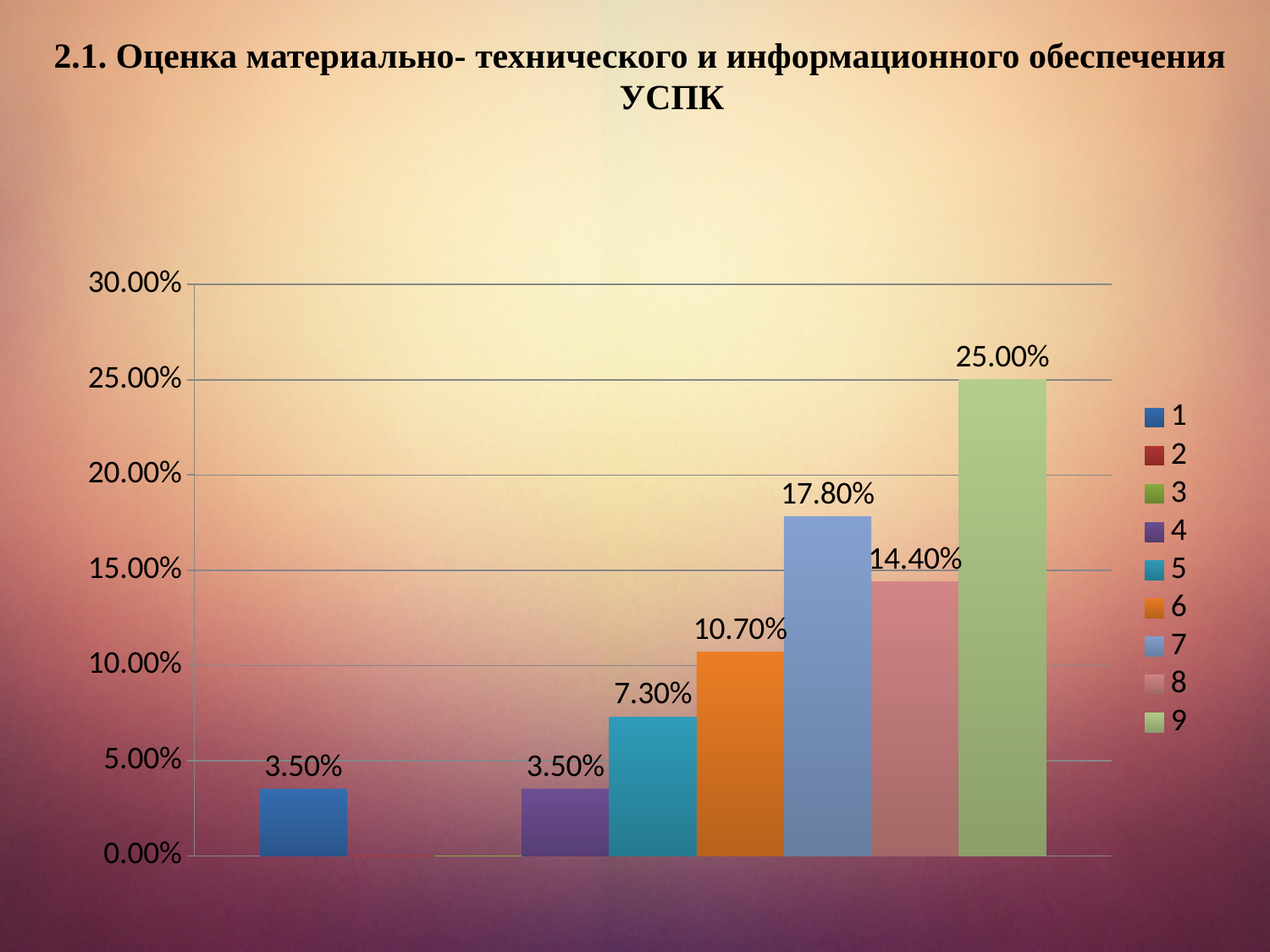
What is the difference between the values for series 9 and series 7? 7.20% How many series does the legend list? 9 What is the value for series 5? 7.30% Which series has the highest value? 9 Which is larger, the value for series 7 or the value for series 8? series 7 What is the difference between the values for series 8 and series 6? 3.70% What is the value for series 9? 25.00% What colour is the bar for series 6? orange What is the value for series 8? 14.40% Is the value for series 6 greater or less than 10.00%? greater What is the value for series 7? 17.80% What kind of chart is shown on the slide? bar chart